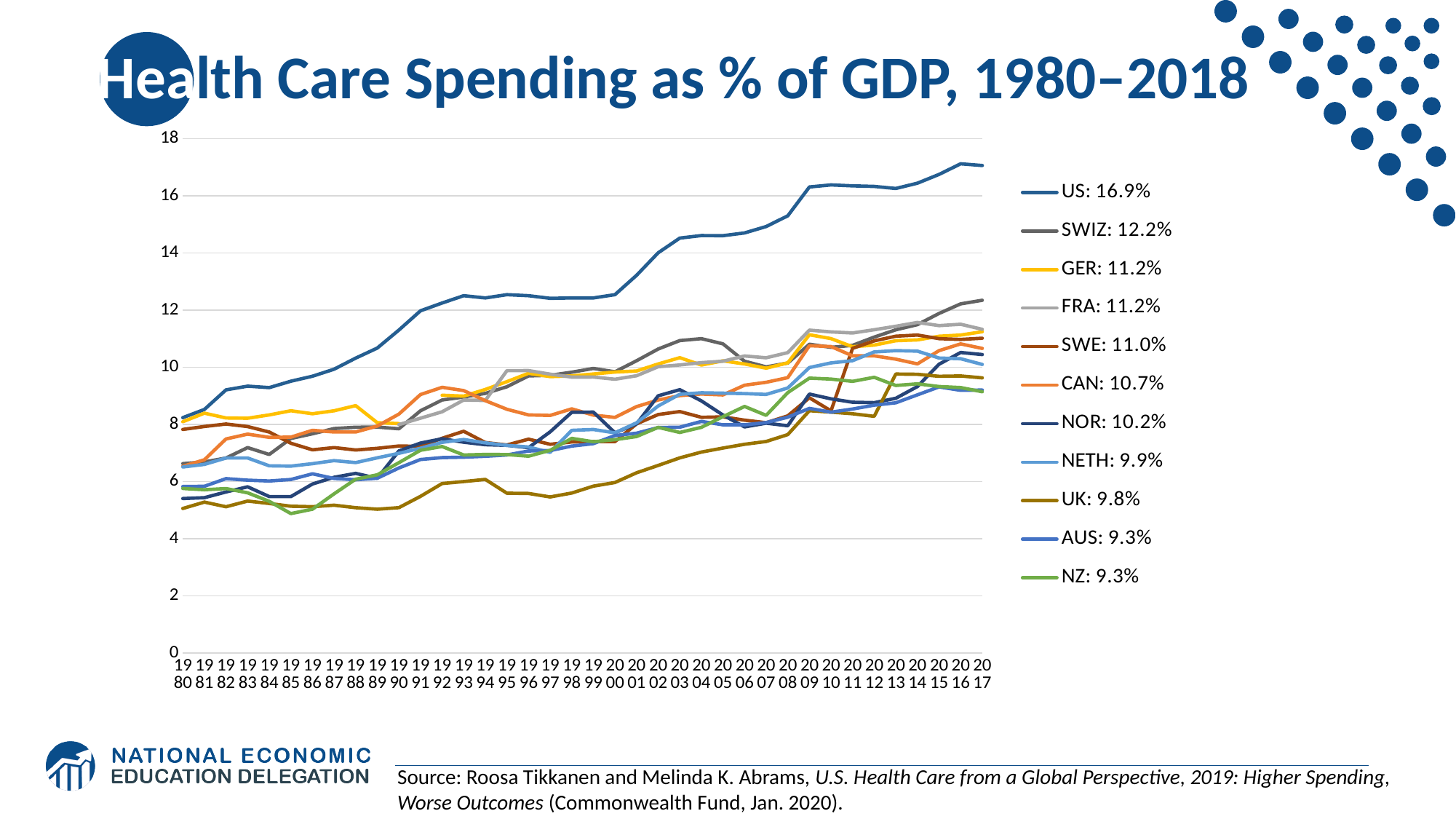
What value does the legend give for SWIZ? 12.2% What kind of chart is shown on the slide? line chart What value does the legend give for CAN? 10.7% What value does the legend give for UK? 9.8% Is the value for the US in 2017 greater or less than 16? greater Which country has the highest health care spending as % of GDP according to the legend? US Which has the larger legend value, SWIZ or GER? SWIZ What value does the legend give for the US? 16.9% What is the title of the chart? Health Care Spending as % of GDP, 1980–2018 Does the US line generally rise or fall from 1980 to 2017? rise What is the difference between the legend values for the US and SWIZ? 4.7 percentage points How many series does the legend list? 11